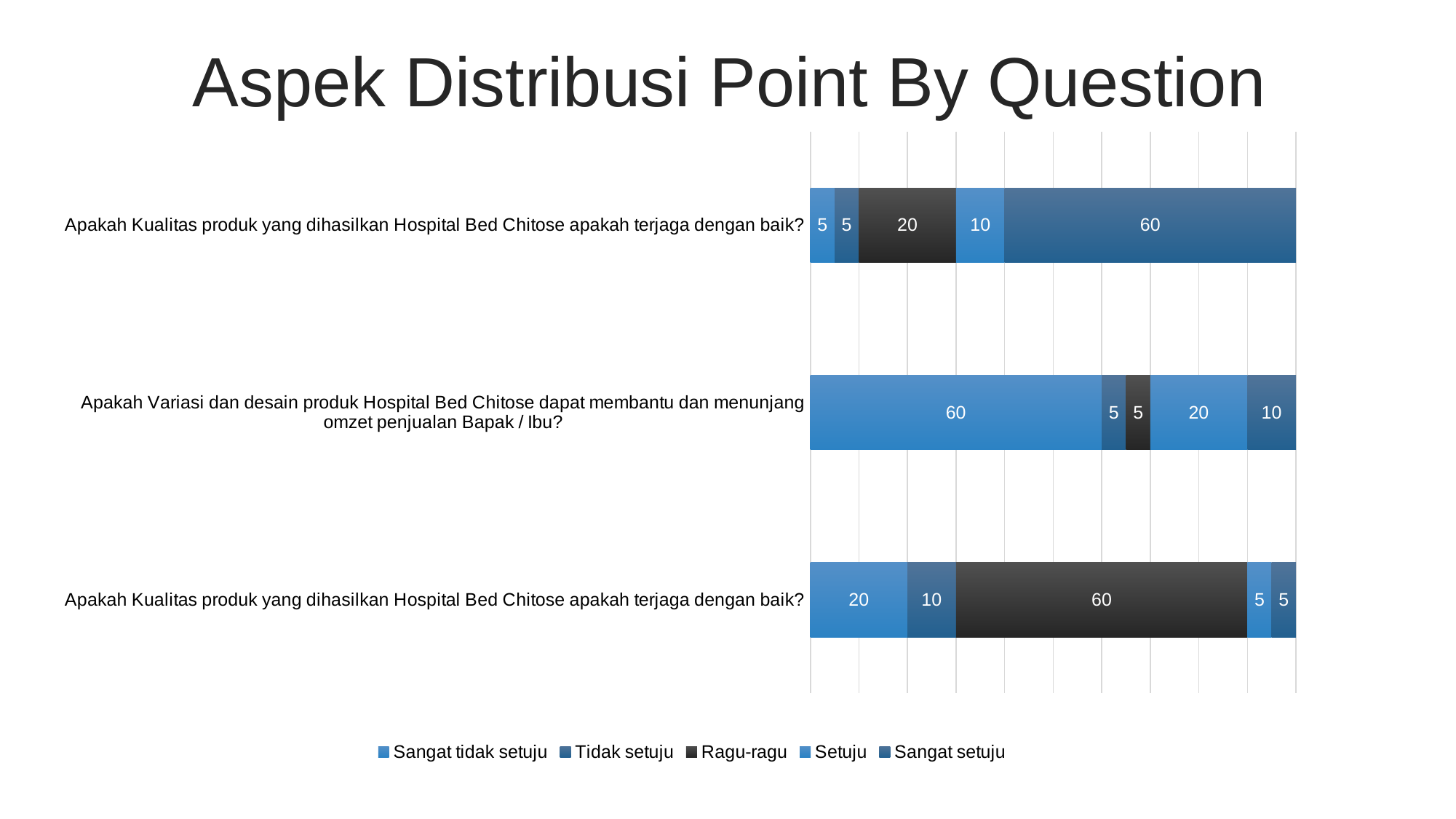
How many question categories (bars) are plotted in the chart? 3 What is the title of the chart slide? Aspek Distribusi Point By Question In the middle bar (Variasi dan desain produk), which series has the largest value? Sangat tidak setuju What is the value for Ragu-ragu in the bottom bar of the chart? 60 What is the total of the stacked bar for 'Apakah Variasi dan desain produk Hospital Bed Chitose dapat membantu dan menunjang omzet penjualan Bapak / Ibu?' 100 What kind of chart is shown on the slide? Stacked bar chart How many series does the legend list? 5 What is the value for Ragu-ragu in the bar for 'Apakah Variasi dan desain produk Hospital Bed Chitose dapat membantu dan menunjang omzet penjualan Bapak / Ibu?' 5 What is the value for Sangat tidak setuju in the middle bar (Variasi dan desain produk)? 60 In the middle bar (Variasi dan desain produk), what is the difference between the Setuju value and the Sangat setuju value? 10 What is the value for Setuju in the bar for 'Apakah Variasi dan desain produk Hospital Bed Chitose dapat membantu dan menunjang omzet penjualan Bapak / Ibu?' 20 What is the value for Ragu-ragu in the top bar of the chart? 20